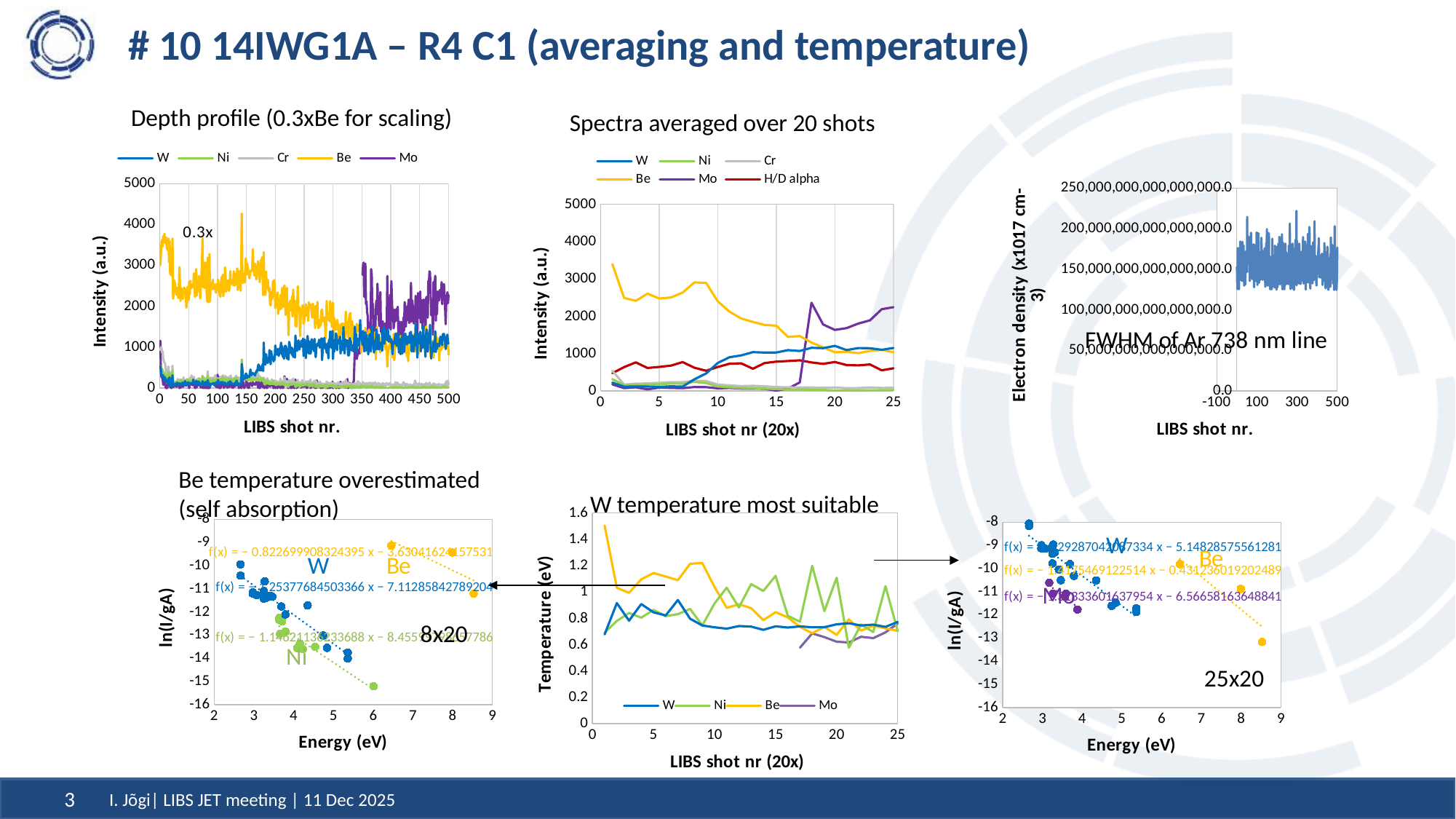
In the 'Spectra averaged over 20 shots' chart, is the value for Mo at LIBS shot 10 greater or less than 1000? less In the 'W temperature most suitable' chart (bottom middle), is the value for Be at LIBS shot 1 greater or less than 1.4? greater In the 'Spectra averaged over 20 shots' chart, does the Be series rise or fall from LIBS shot 1 to shot 25? fall How many series does the legend of the 'W temperature most suitable' chart (bottom middle) list? 4 What is the y-axis label of the bottom-left scatter chart labelled '8x20'? ln(I/gA) In the 'Spectra averaged over 20 shots' chart, which series has the highest value at LIBS shot 1? Be How many series does the legend of the 'Depth profile (0.3xBe for scaling)' chart list? 5 How many series does the legend of the 'Spectra averaged over 20 shots' chart list? 6 In the 'Depth profile (0.3xBe for scaling)' chart, is the value for W at LIBS shot 400 greater or less than 2000? less What kind of chart is the 'Spectra averaged over 20 shots' chart? line chart What is the x-axis label of the 'W temperature most suitable' chart (bottom middle)? LIBS shot nr (20x)